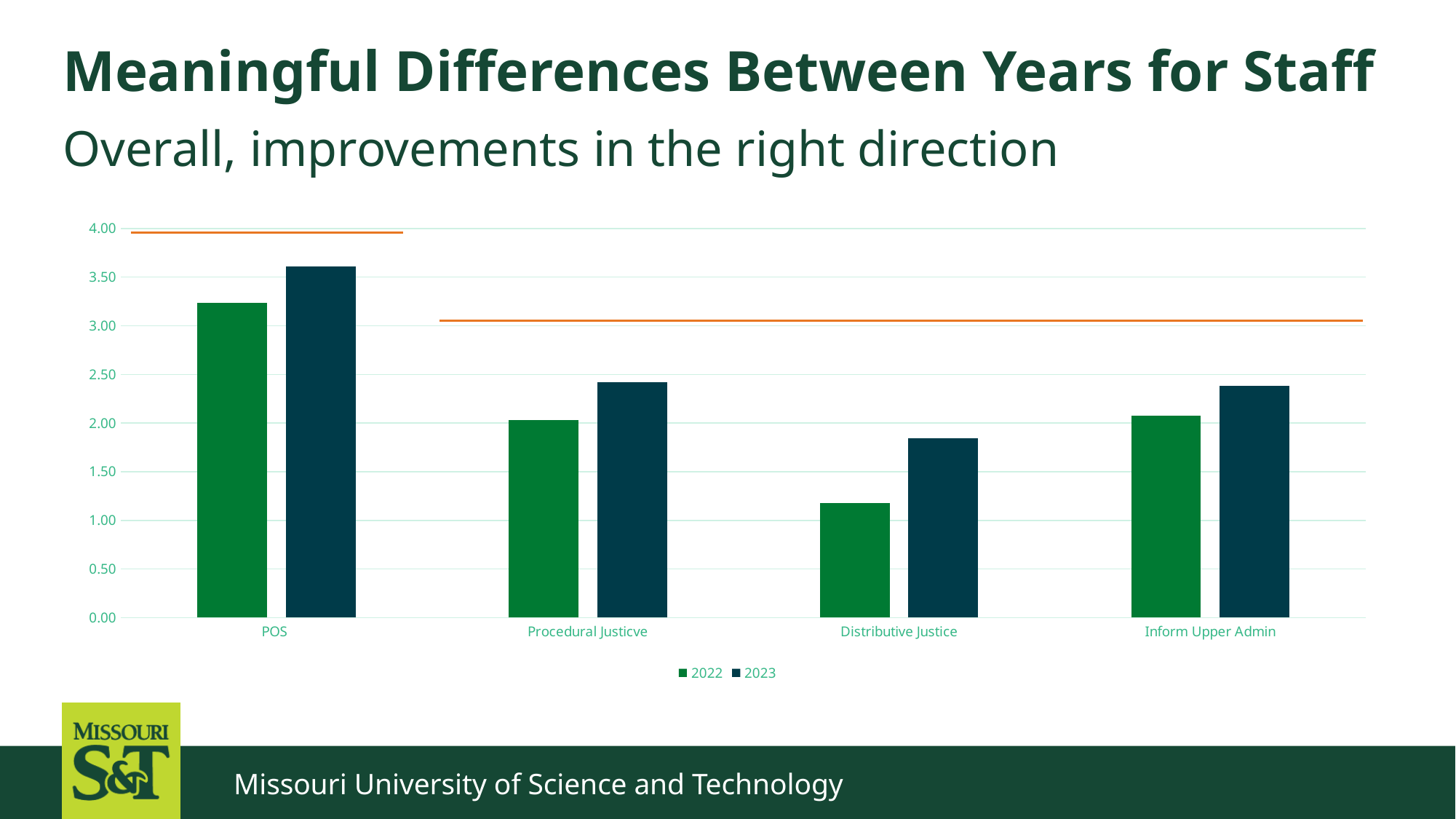
How many series does the chart's legend list? 2 What are the two series listed in the chart's legend? 2022 and 2023 Is the 2022 value for Distributive Justice greater or less than 1.50? less Which category has the highest 2023 value? POS Which category has the lowest 2022 value? Distributive Justice How many categories are shown on the x axis of the chart? 4 Is the 2023 value for POS greater or less than 3.50? greater Which is larger: the 2022 value for POS or the 2023 value for Procedural Justicve? the 2022 value for POS For Distributive Justice, which year has the larger value, 2022 or 2023? 2023 What kind of chart is shown on the slide? bar chart Is the 2023 value for Procedural Justicve greater or less than 2.00? greater